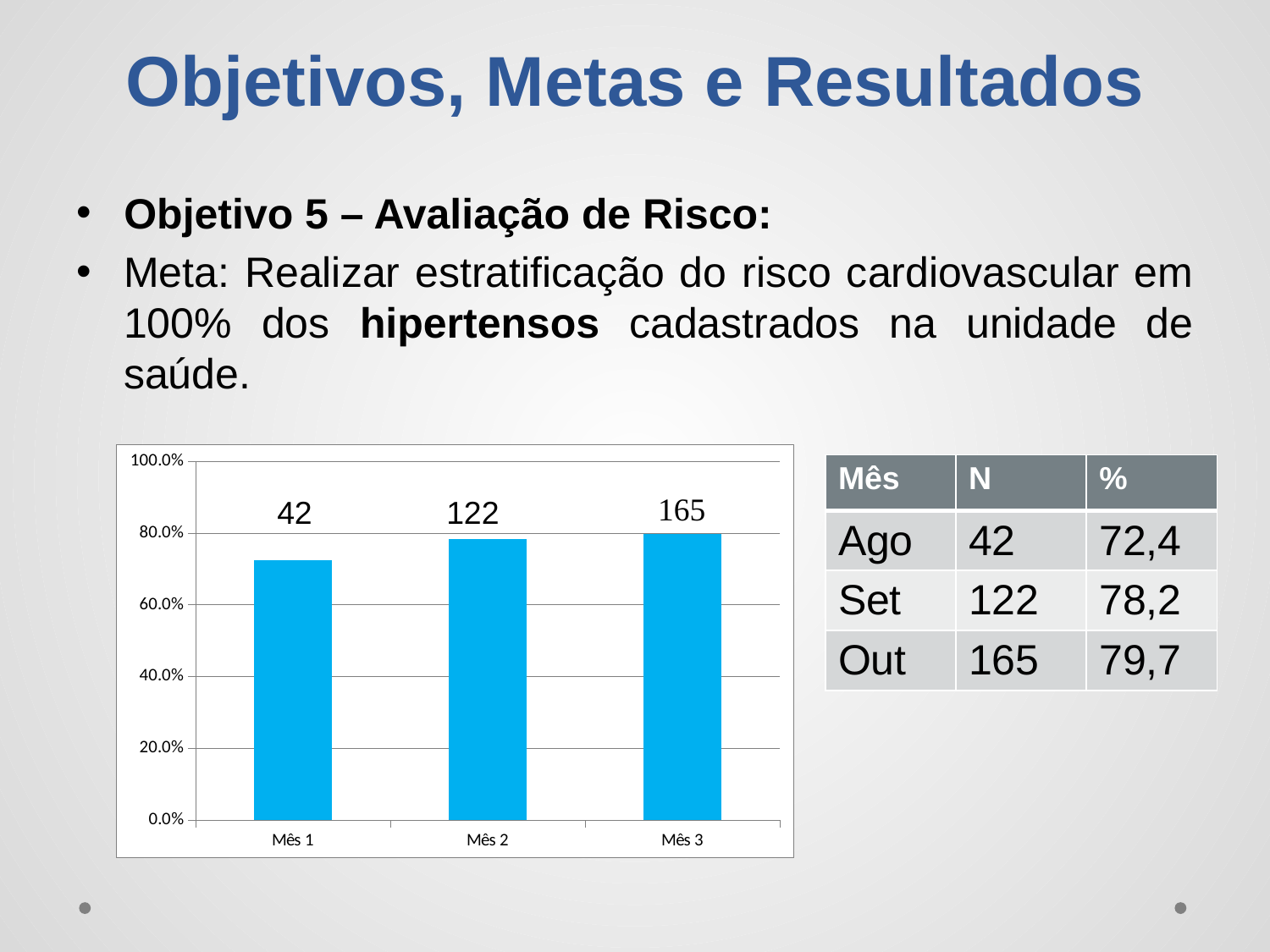
Which category has the highest data label value? Mês 3 What type of chart is shown on the slide? bar chart What is the difference between the data labels for Mês 2 and Mês 1? 80 Is the bar for Mês 1 greater or less than 60.0%? greater What is the data label shown on the bar for Mês 2? 122 What is the data label shown on the bar for Mês 1? 42 Which bar is taller, Mês 1 or Mês 3? Mês 3 Is the bar for Mês 1 greater or less than 80.0%? less What is the data label shown on the bar for Mês 3? 165 What is the difference between the data labels for Mês 3 and Mês 1? 123 How many categories are shown on the x axis of the chart? 3 Which category has the lowest bar? Mês 1